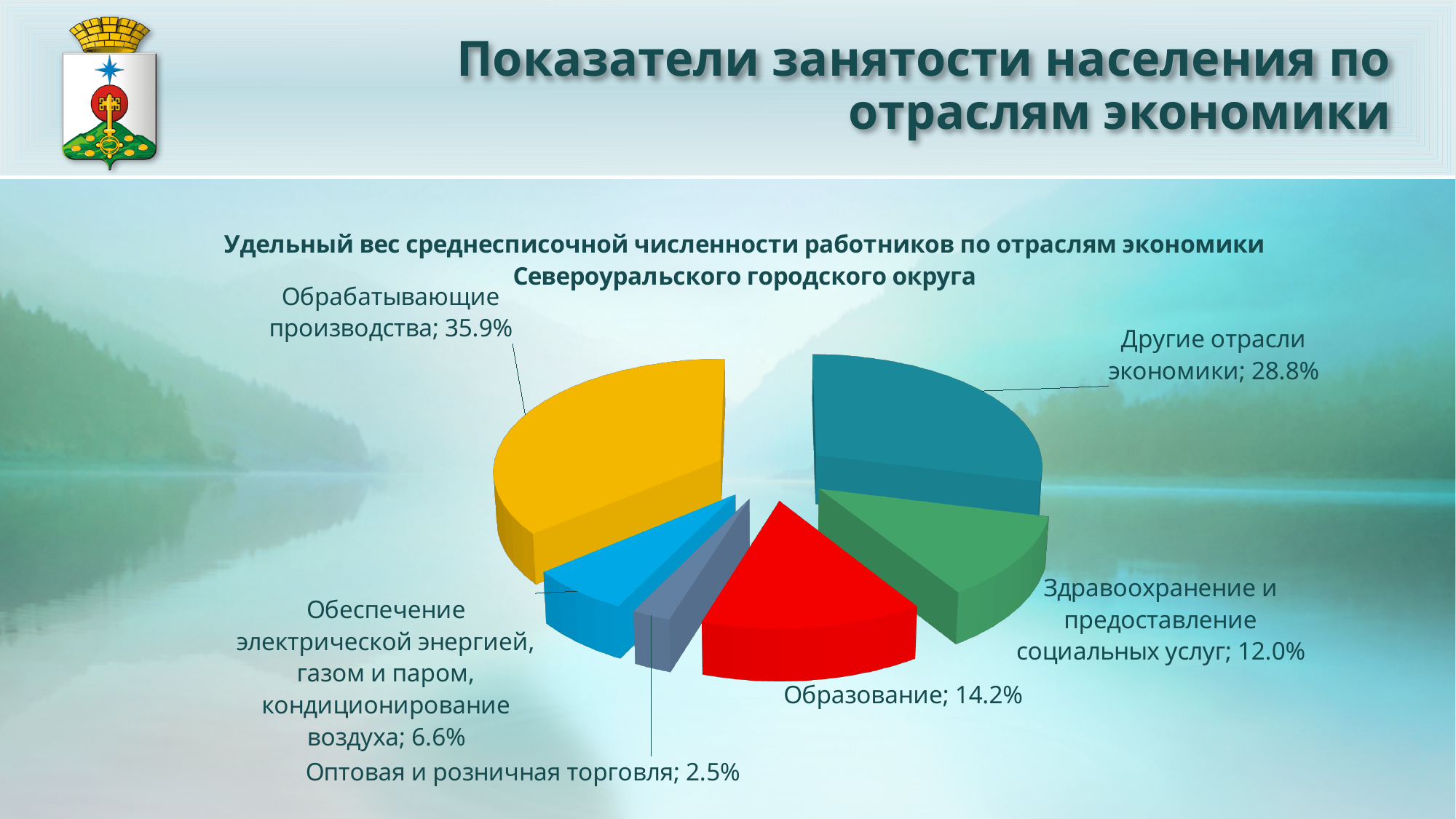
What type of chart is shown on the slide? Pie chart Which is larger: the share for Образование or the share for Здравоохранение и предоставление социальных услуг? Образование Which category has the largest share of the pie? Обрабатывающие производства What colour is the slice for Образование? Red What is the share for Оптовая и розничная торговля? 2.5% Which category has the smallest share of the pie? Оптовая и розничная торговля What is the share for Образование? 14.2% What is the difference between the shares of Обрабатывающие производства and Другие отрасли экономики? 7.1% What is the share for Другие отрасли экономики? 28.8% How many slices does the pie chart have? 6 What is the share for Обрабатывающие производства? 35.9% What is the share for Здравоохранение и предоставление социальных услуг? 12.0%